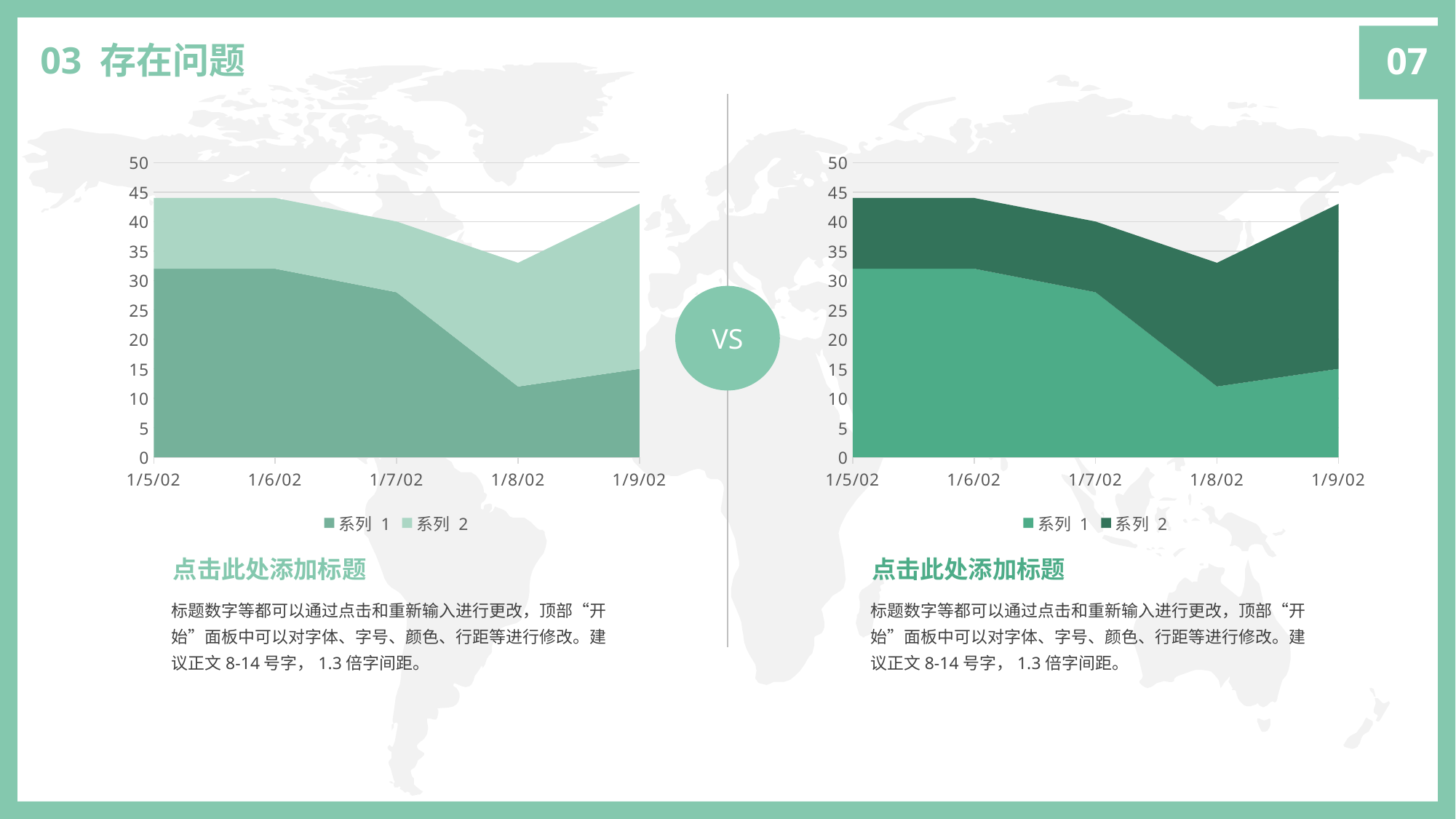
In the right chart, is the stacked total at 1/8/02 greater or less than 35? less In the right chart, is the value of 系列 1 at 1/5/02 greater or less than 30? greater What are the names of the two series in the left chart's legend? 系列 1 and 系列 2 How many dates are shown on the x axis of the left chart? 5 In the left chart, is the value of 系列 1 at 1/7/02 greater or less than 25? greater How many series does the legend of the right chart list? 2 In the left chart, at which date is 系列 1 lowest? 1/8/02 In the left chart, does 系列 1 rise or fall from 1/5/02 to 1/8/02? fall In the right chart, which is larger for 系列 1: the value at 1/7/02 or at 1/8/02? 1/7/02 What kind of chart is the left chart? area chart